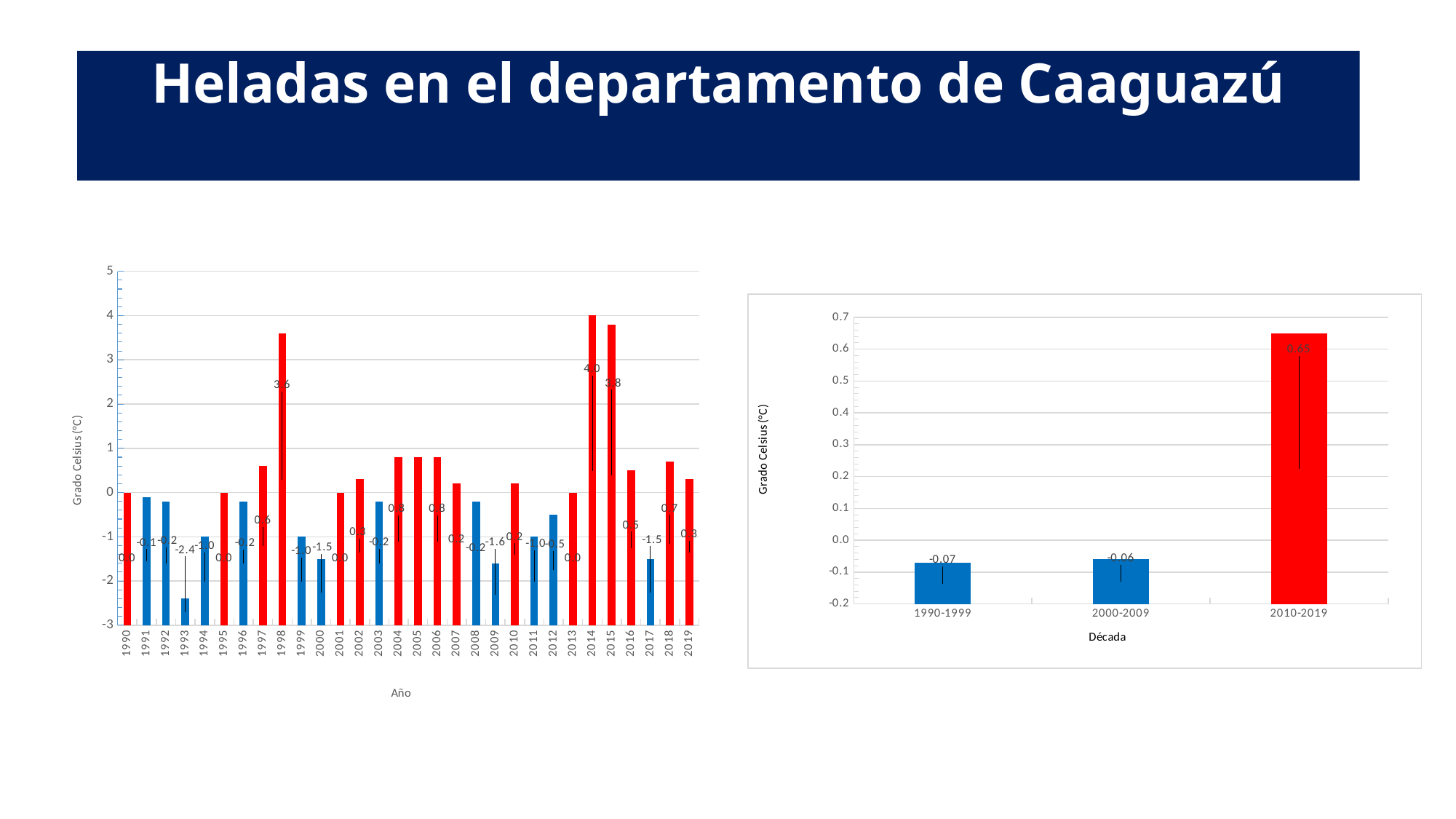
In the left chart (by year), which year has the lowest value? 1993 In the right chart (by decade), what is the value for 1990-1999? -0.07 In the left chart (by year), what is the value for 2014? 4.0 In the right chart (by decade), what is the value for 2010-2019? 0.65 In the left chart (by year), what is the value for 1998? 3.6 What kind of chart is the right chart (by decade)? bar chart In the left chart (by year), what is the value for 1993? -2.4 In the left chart (by year), which year has the highest value? 2014 In the right chart (by decade), which decade has the highest value? 2010-2019 In the left chart (by year), which is larger, the value for 2014 or the value for 1998? 2014 In the right chart (by decade), how many decades are shown? 3 In the left chart (by year), is the value for 2015 greater or less than 3? greater